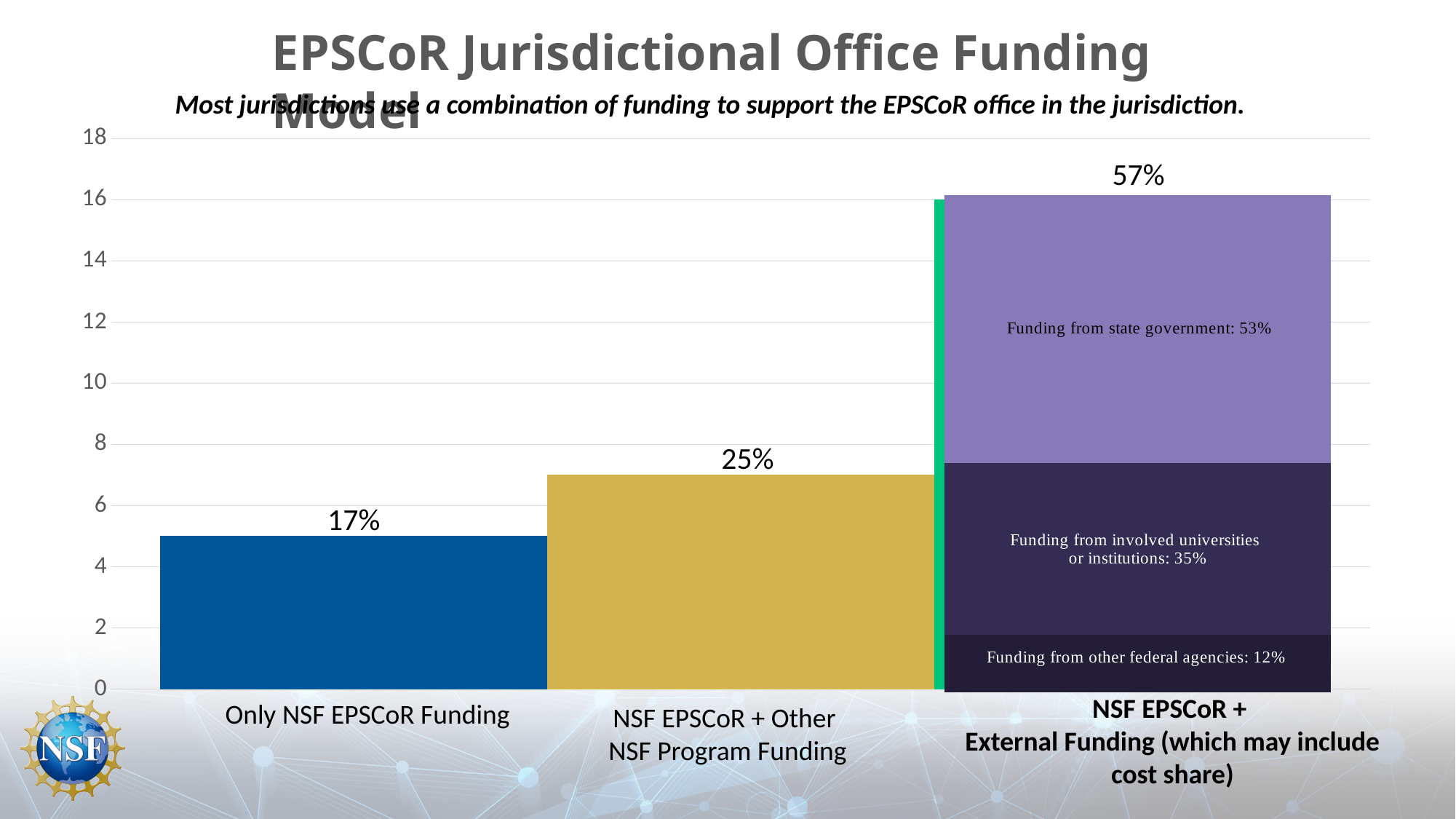
On the y axis, is the bar for Only NSF EPSCoR Funding greater or less than 6? less What percentage is shown for Only NSF EPSCoR Funding? 17% What percentage is shown for NSF EPSCoR + External Funding (which may include cost share)? 57% What percentage is shown for NSF EPSCoR + Other NSF Program Funding? 25% Which is larger: the percentage for NSF EPSCoR + Other NSF Program Funding or for Only NSF EPSCoR Funding? NSF EPSCoR + Other NSF Program Funding Within the NSF EPSCoR + External Funding bar, what percentage is attributed to funding from state government? 53% Which funding model has the highest percentage? NSF EPSCoR + External Funding (which may include cost share) What kind of chart is shown on the slide? bar chart What is the difference in percentage points between NSF EPSCoR + External Funding and Only NSF EPSCoR Funding? 40 percentage points How many funding model categories are shown on the x axis? 3 Which funding model has the lowest percentage? Only NSF EPSCoR Funding Within the NSF EPSCoR + External Funding bar, what percentage is attributed to funding from other federal agencies? 12%